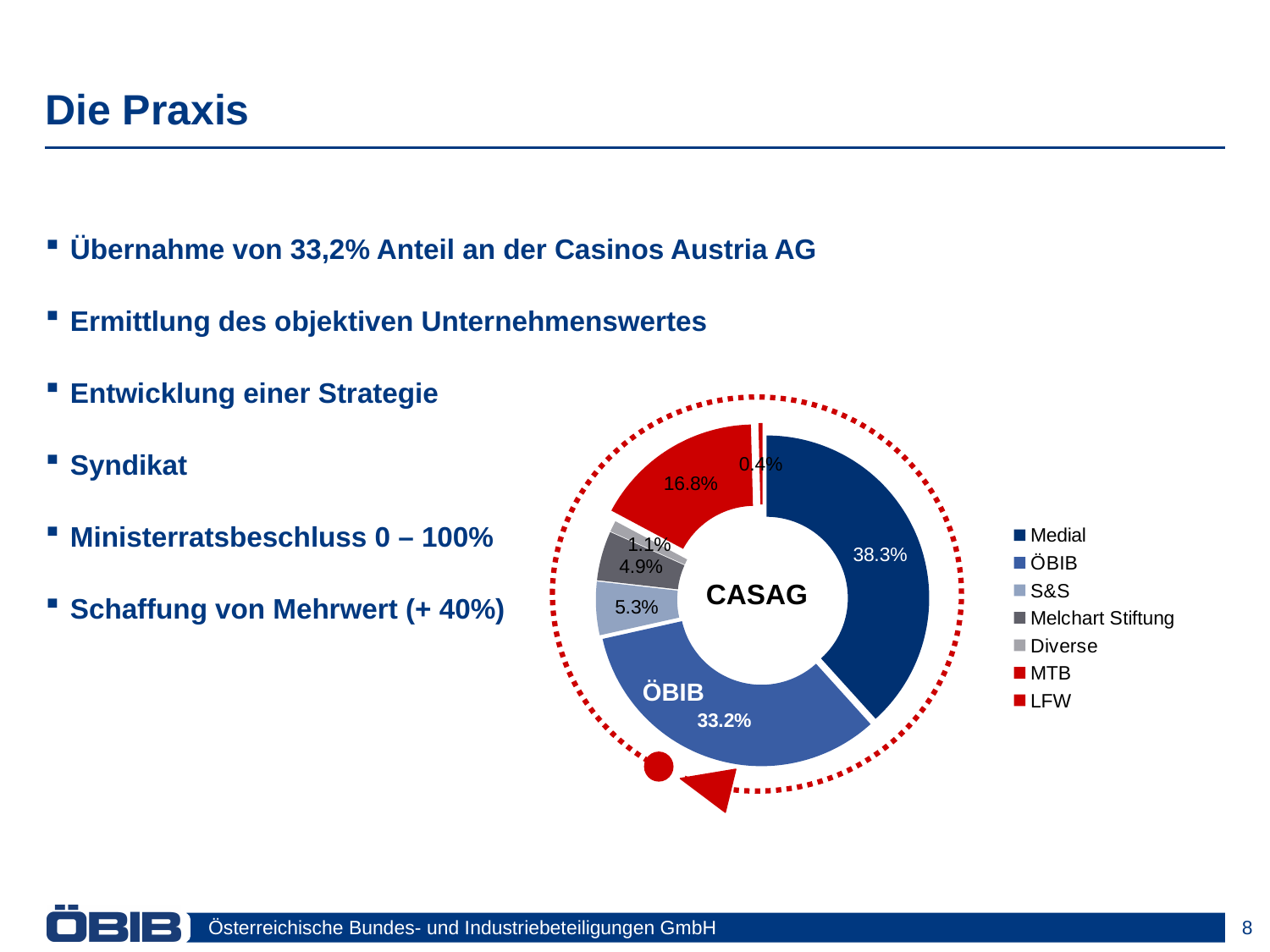
Which is larger in the chart, the share of MTB or the share of S&S? MTB What share of CASAG does ÖBIB hold according to the chart? 33.2% Which shareholder has the smallest share in the CASAG chart? LFW What percentage is shown for MTB in the chart? 16.8% What share of CASAG does Medial hold according to the chart? 38.3% What percentage is shown for Melchart Stiftung in the chart? 4.9% What is the difference between the Medial share and the ÖBIB share in the chart? 5.1% What kind of chart is shown on the slide? doughnut chart How many shareholders does the legend of the CASAG chart list? 7 Which shareholder has the largest share in the CASAG chart? Medial What label is printed in the centre of the chart? CASAG What percentage is shown for S&S in the chart? 5.3%